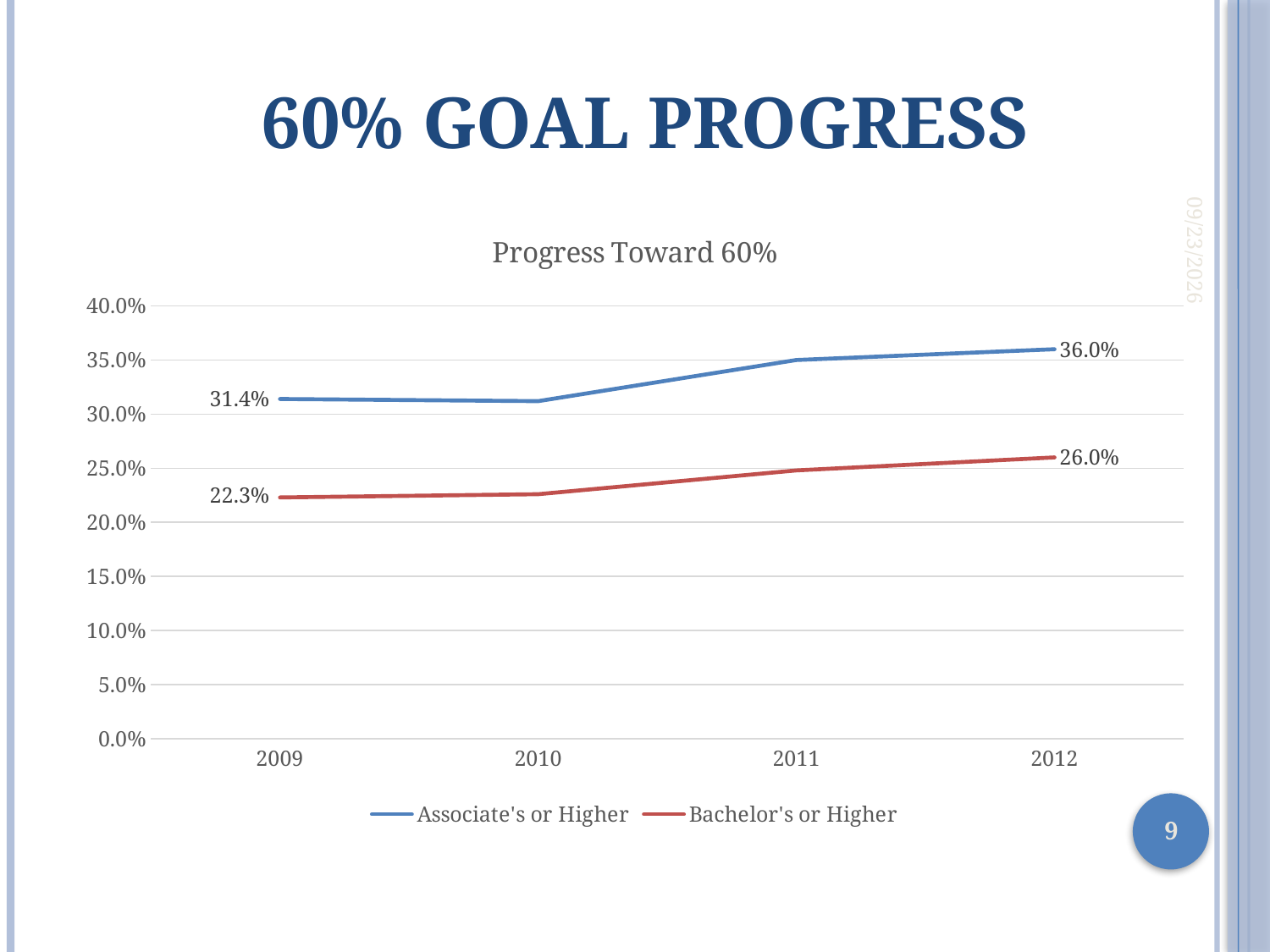
What is the value for Bachelor's or Higher in 2012? 26.0% What is the value for Associate's or Higher in 2012? 36.0% How many series does the legend list? 2 What is the value for Bachelor's or Higher in 2009? 22.3% Which series is higher in 2011, Associate's or Higher or Bachelor's or Higher? Associate's or Higher What is the value for Associate's or Higher in 2009? 31.4% What is the difference between Associate's or Higher and Bachelor's or Higher in 2012? 10.0% By how much did Associate's or Higher increase from 2009 to 2012? 4.6% How many years are shown on the x axis? 4 Is the value for Associate's or Higher in 2011 greater or less than 40.0%? less What kind of chart is shown on the slide? Line chart Is the value for Bachelor's or Higher in 2011 greater or less than 20.0%? greater